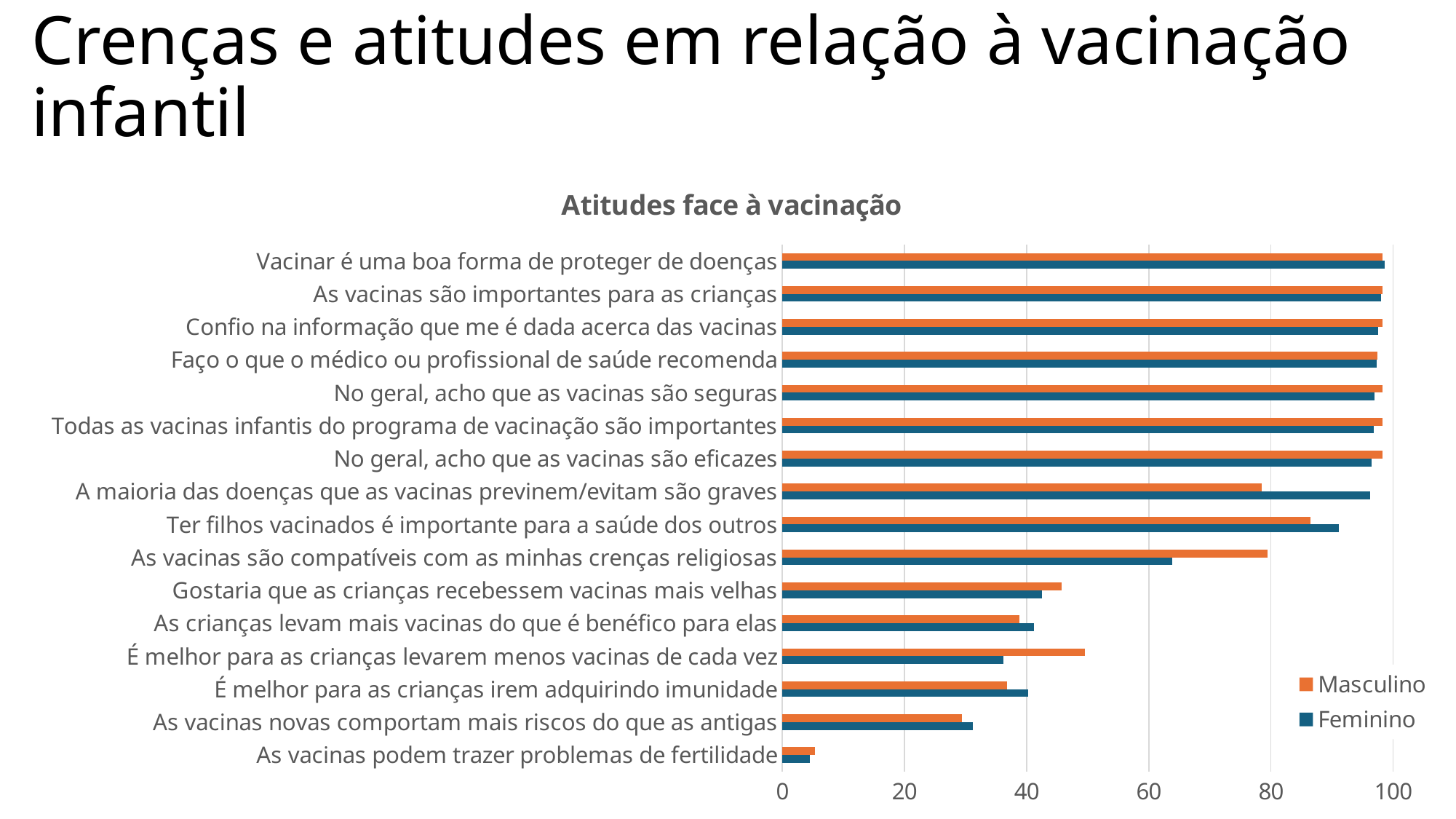
Which colour represents the Feminino series in the chart? blue For 'As vacinas são compatíveis com as minhas crenças religiosas', which series is larger, Masculino or Feminino? Masculino Is the Masculino value for 'As vacinas novas comportam mais riscos do que as antigas' greater or less than 40? less What is the title of the chart? Atitudes face à vacinação How many categories (statements) are plotted in the chart? 16 How many series does the legend list? 2 What kind of chart is shown on the slide? bar chart Is the Feminino value for 'A maioria das doenças que as vacinas previnem/evitam são graves' greater or less than 80? greater Which category has the lowest values for both Masculino and Feminino? As vacinas podem trazer problemas de fertilidade For 'É melhor para as crianças levarem menos vacinas de cada vez', which series is larger, Masculino or Feminino? Masculino Is the Masculino value for 'Gostaria que as crianças recebessem vacinas mais velhas' greater or less than 40? greater For 'A maioria das doenças que as vacinas previnem/evitam são graves', which series is larger, Masculino or Feminino? Feminino